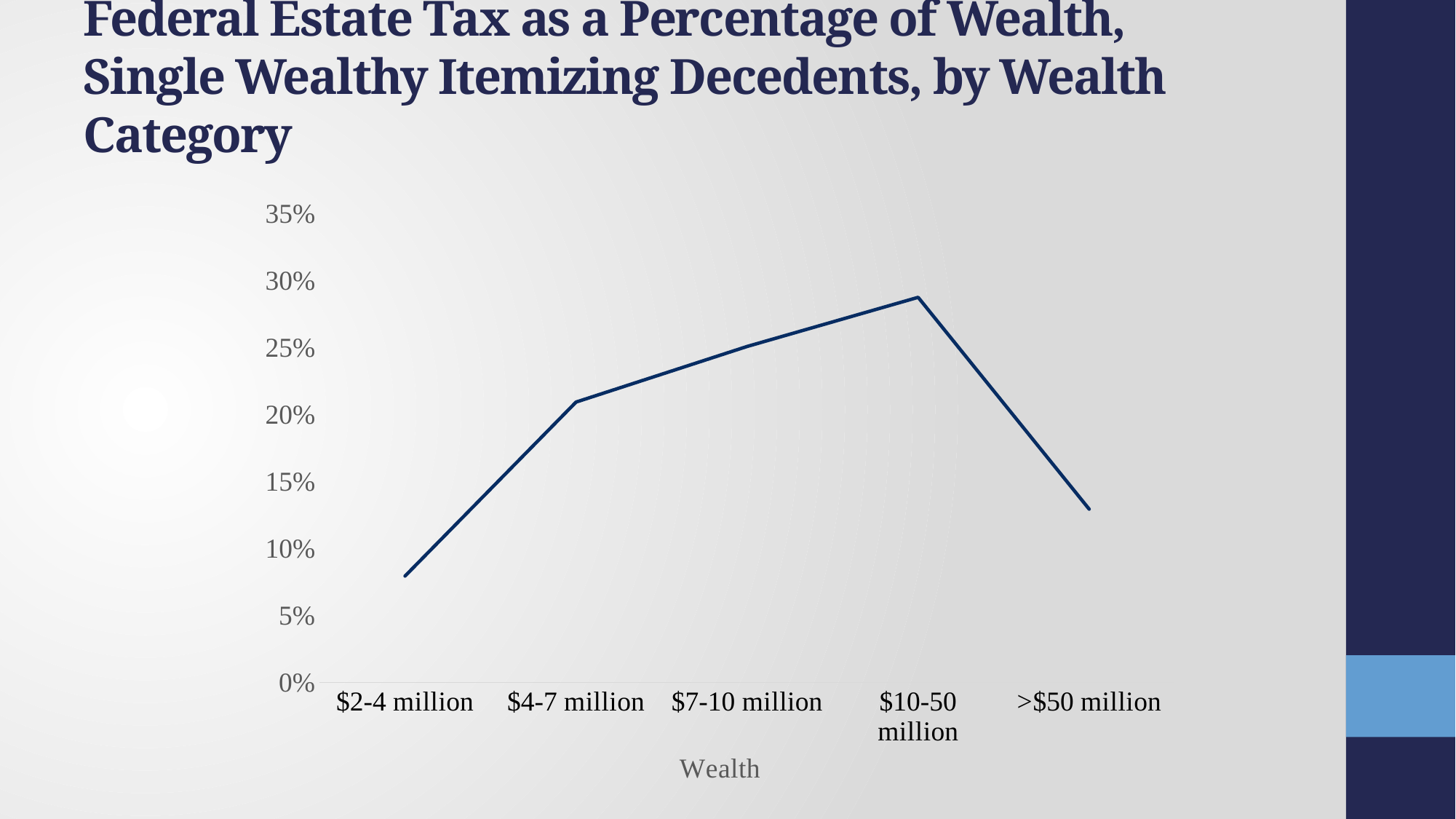
Is the value for $7-10 million greater or less than 20%? greater Is the value for $2-4 million greater or less than 10%? less Which wealth category has the lowest federal estate tax as a percentage of wealth? $2-4 million Is the value for $10-50 million greater or less than 25%? greater Which is larger, the value for $4-7 million or the value for >$50 million? $4-7 million How does the line move across the wealth categories from left to right? rises up to $10-50 million, then falls What is the title of the x axis? Wealth What kind of chart is shown on the slide? line chart How many wealth categories are plotted on the x axis? 5 Which wealth category has the highest federal estate tax as a percentage of wealth? $10-50 million